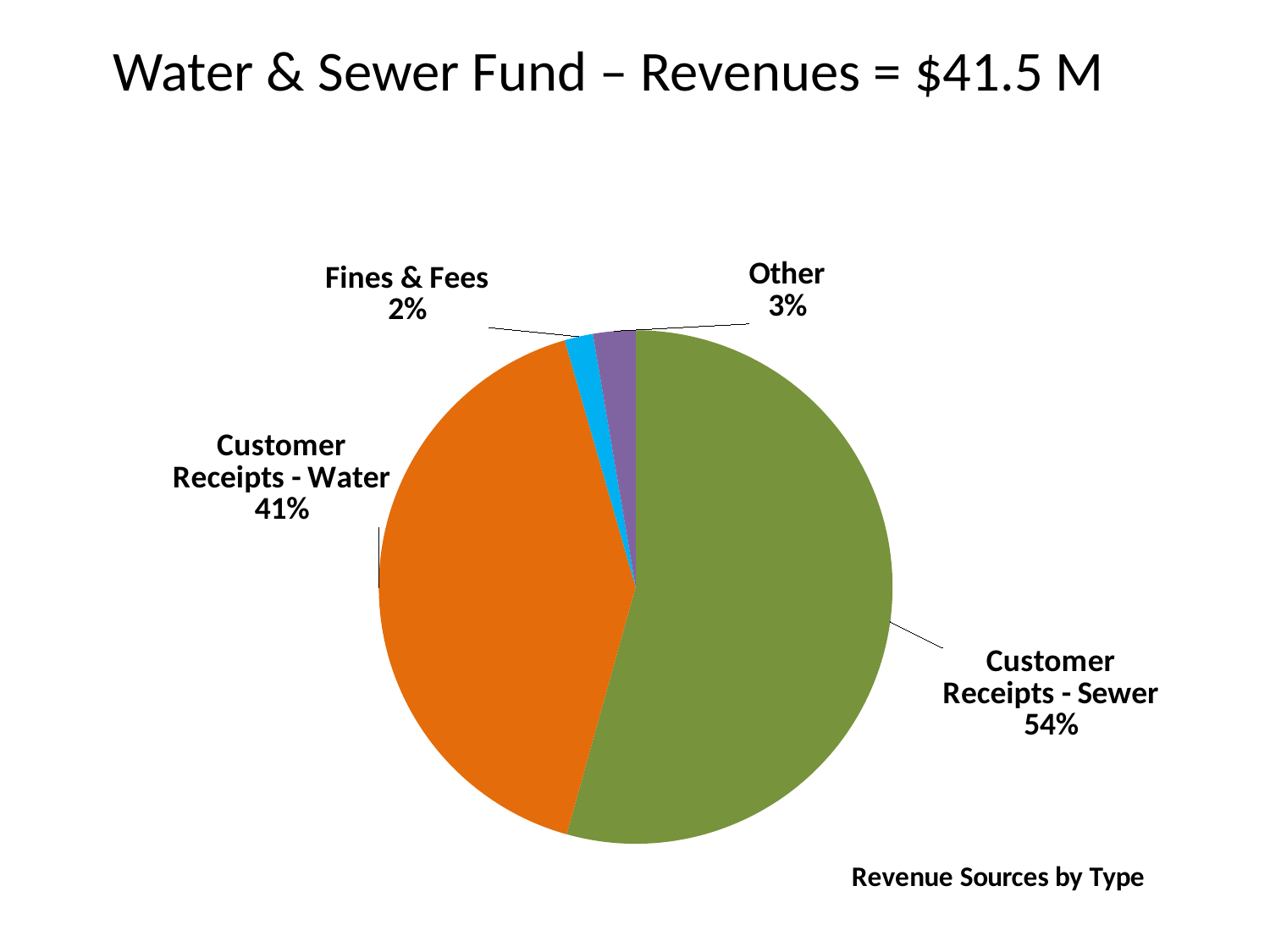
What share of revenue comes from Customer Receipts - Sewer? 54% What is the difference in percentage points between Customer Receipts - Sewer and Customer Receipts - Water? 13 percentage points What is the title of the slide? Water & Sewer Fund – Revenues = $41.5 M Which is larger, the share for Other or the share for Fines & Fees? Other What kind of chart is shown on the slide? Pie chart Which revenue source has the largest share of the pie? Customer Receipts - Sewer What percentage of revenue is from Fines & Fees? 2% How many slices does the pie chart have? 4 What colour is the Customer Receipts - Water slice? Orange What percentage of revenue is labelled Other? 3% What share of revenue comes from Customer Receipts - Water? 41% Which revenue source has the smallest share of the pie? Fines & Fees